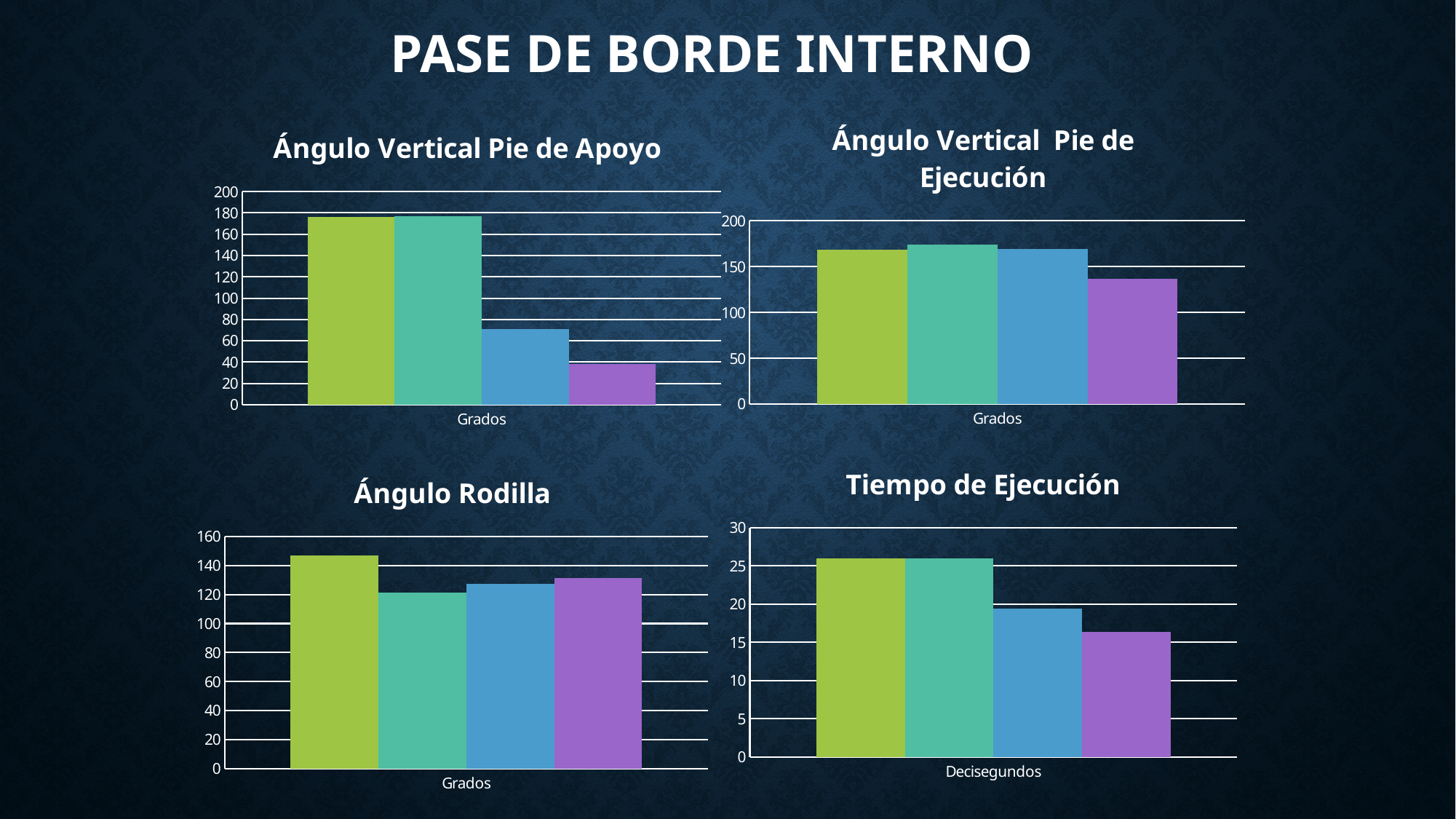
In the 'Ángulo Vertical Pie de Apoyo' chart, which bar is the lowest? the purple bar What is the x-axis label of the 'Tiempo de Ejecución' chart? Decisegundos In the 'Ángulo Vertical Pie de Apoyo' chart, is the value of the green bar greater or less than 160? greater In the 'Ángulo Rodilla' chart, which bar is the highest? the green bar In the 'Ángulo Rodilla' chart, is the value of the teal bar greater or less than 140? less In the 'Ángulo Vertical Pie de Ejecución' chart, which bar is the lowest? the purple bar In the 'Ángulo Vertical Pie de Ejecución' chart, is the value of the purple bar greater or less than 150? less What kind of chart is the 'Ángulo Rodilla' chart? bar chart In the 'Tiempo de Ejecución' chart, which is larger, the green bar or the purple bar? the green bar How many bars are plotted in the 'Tiempo de Ejecución' chart? 4